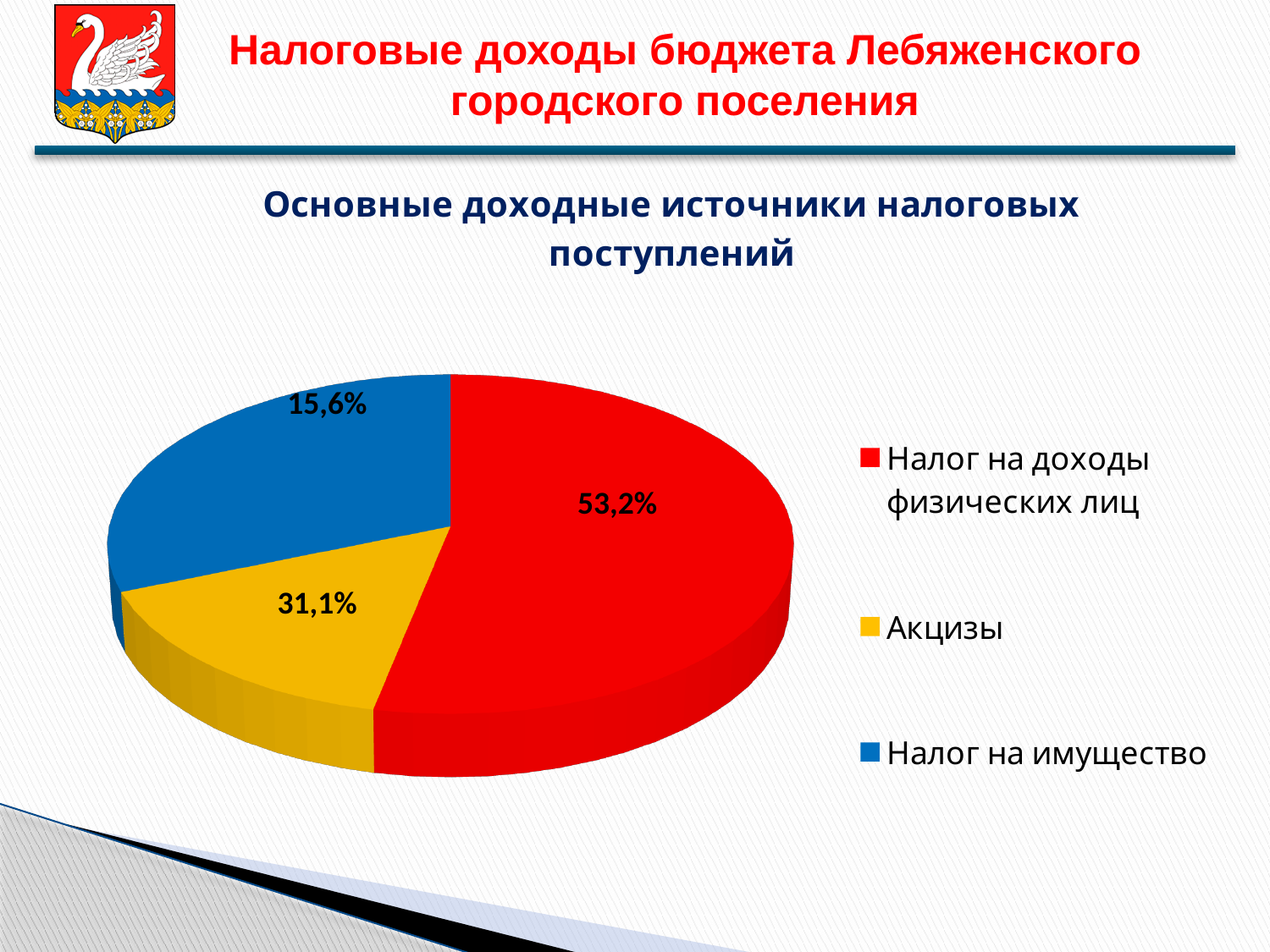
What is the title of the chart? Основные доходные источники налоговых поступлений What share of tax revenue comes from Налог на имущество? 31,1% Which source has the smallest share of tax revenue? Акцизы What colour is the slice for Акцизы? Yellow How many slices does the pie chart have? 3 What is the difference in percentage points between Акцизы and Налог на имущество? 15,5 What type of chart is shown on the slide? Pie chart Which is larger: the share of Акцизы or the share of Налог на имущество? Налог на имущество What is the difference in percentage points between Налог на доходы физических лиц and Акцизы? 37,6 What share of tax revenue comes from Акцизы? 15,6% Which source has the largest share of tax revenue? Налог на доходы физических лиц What share of tax revenue comes from Налог на доходы физических лиц? 53,2%